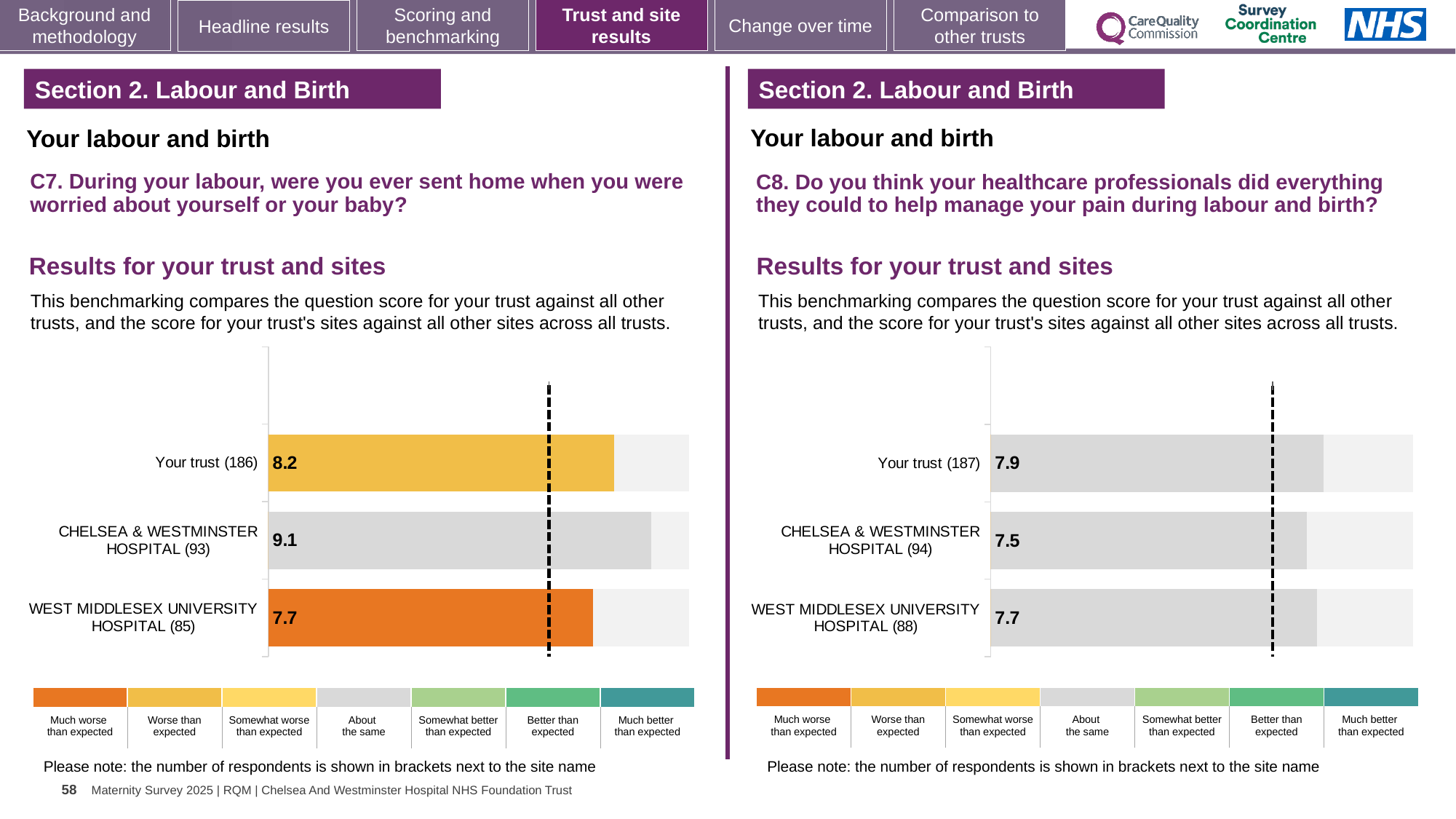
In the C7 chart on the left, what is the score for CHELSEA & WESTMINSTER HOSPITAL (93)? 9.1 What type of chart is used in the C7 chart on the left? Bar chart In the C8 chart on the right, what is the score for CHELSEA & WESTMINSTER HOSPITAL (94)? 7.5 How many bars are shown in the C8 chart on the right? 3 In the C7 chart on the left, what is the score for Your trust (186)? 8.2 In the C8 chart on the right, what is the score for Your trust (187)? 7.9 In the C8 chart on the right, which is larger: the score for Your trust (187) or for WEST MIDDLESEX UNIVERSITY HOSPITAL (88)? Your trust (187) In the C8 chart on the right, which bar has the lowest score? CHELSEA & WESTMINSTER HOSPITAL (94) In the C7 chart on the left, what is the difference between the scores for CHELSEA & WESTMINSTER HOSPITAL (93) and WEST MIDDLESEX UNIVERSITY HOSPITAL (85)? 1.4 In the C7 chart on the left, what is the score for WEST MIDDLESEX UNIVERSITY HOSPITAL (85)? 7.7 In the C7 chart on the left, which benchmark category does the colour of the WEST MIDDLESEX UNIVERSITY HOSPITAL (85) bar correspond to? Much worse than expected In the C7 chart on the left, which bar has the highest score? CHELSEA & WESTMINSTER HOSPITAL (93)